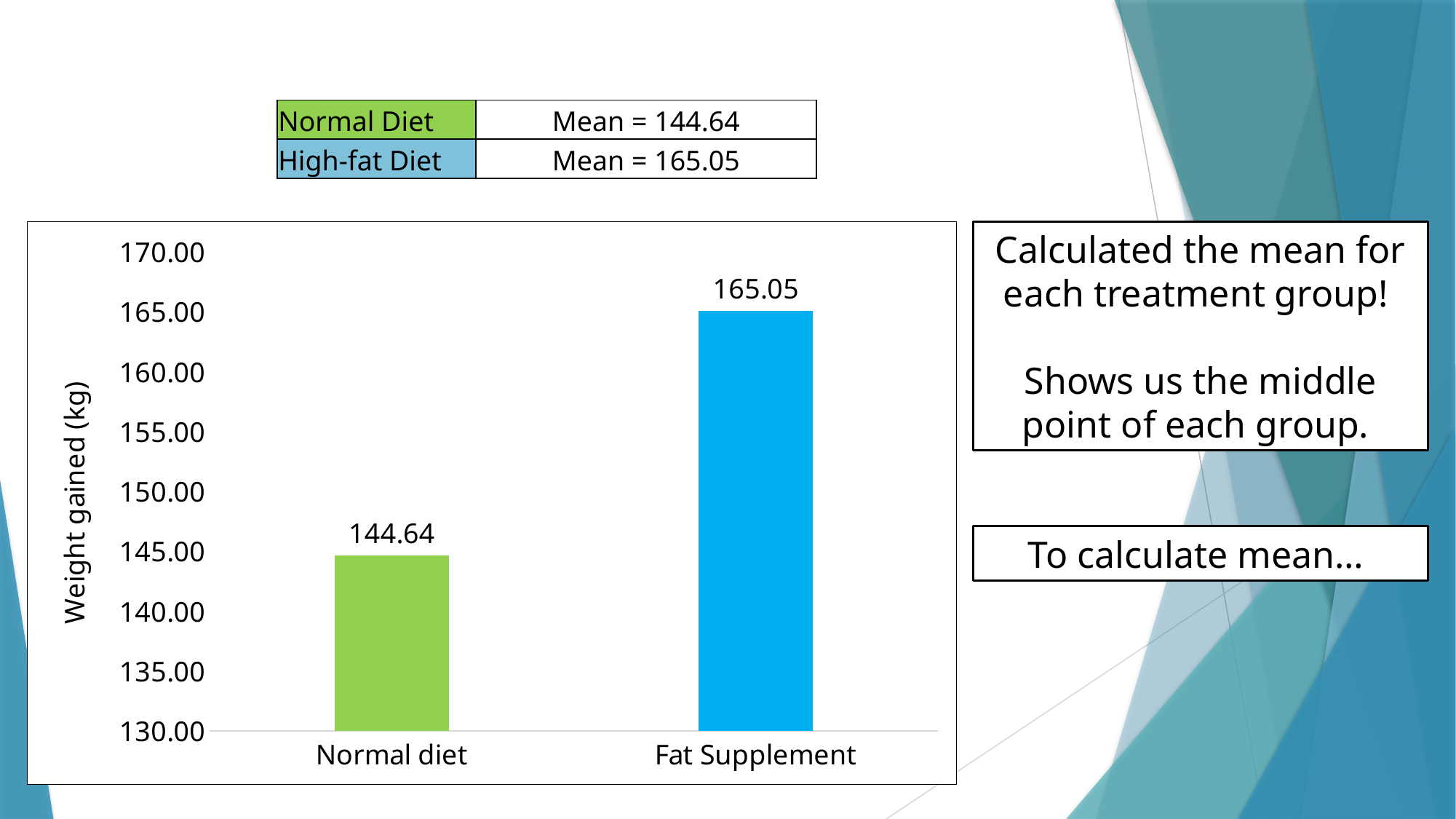
Which category has the lowest value? Normal diet What kind of chart is shown on the slide? bar chart How many categories are shown on the x axis? 2 Which category has the highest value? Fat Supplement What colour is the bar for Fat Supplement? blue What is the value for Normal diet? 144.64 What is the difference between the Fat Supplement and Normal diet values? 20.41 Is the value for Fat Supplement greater or less than 160.00? greater Which is larger, the value for Normal diet or the value for Fat Supplement? Fat Supplement What is the label of the vertical axis? Weight gained (kg) Is the value for Normal diet greater or less than 150.00? less What is the value for Fat Supplement? 165.05